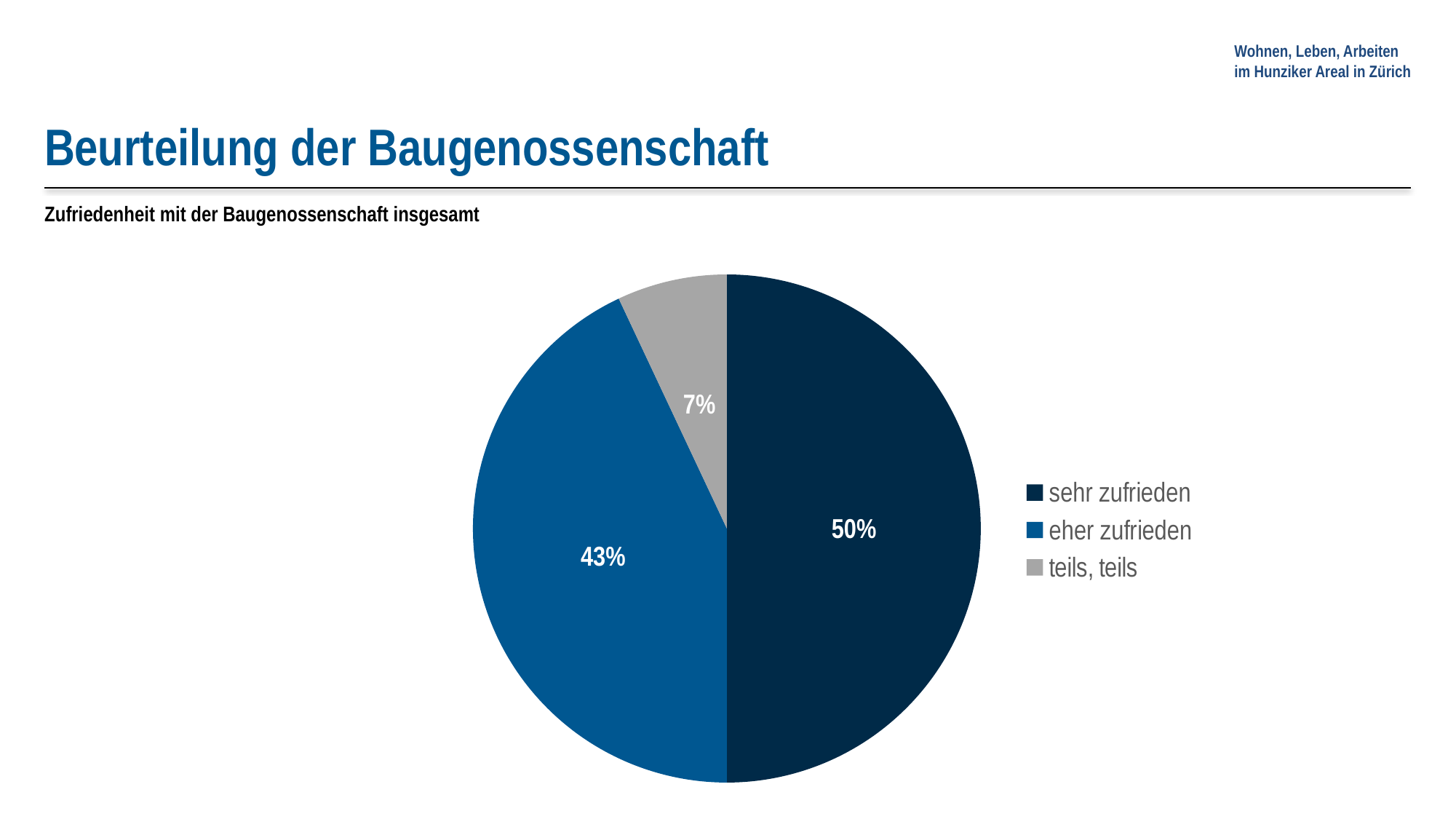
Which is larger, the share for "eher zufrieden" or the share for "teils, teils"? eher zufrieden What is the subtitle of the chart on the slide? Zufriedenheit mit der Baugenossenschaft insgesamt What share of the pie is labelled "teils, teils"? 7% Which category has the largest slice of the pie? sehr zufrieden What share of the pie is labelled "eher zufrieden"? 43% How many categories does the pie chart show? 3 What is the difference in percentage points between "sehr zufrieden" and "eher zufrieden"? 7 Which colour represents "teils, teils" in the legend? grey Which category has the smallest slice of the pie? teils, teils What is the difference in percentage points between "eher zufrieden" and "teils, teils"? 36 What kind of chart is shown on the slide? pie chart What share of the pie is labelled "sehr zufrieden"? 50%